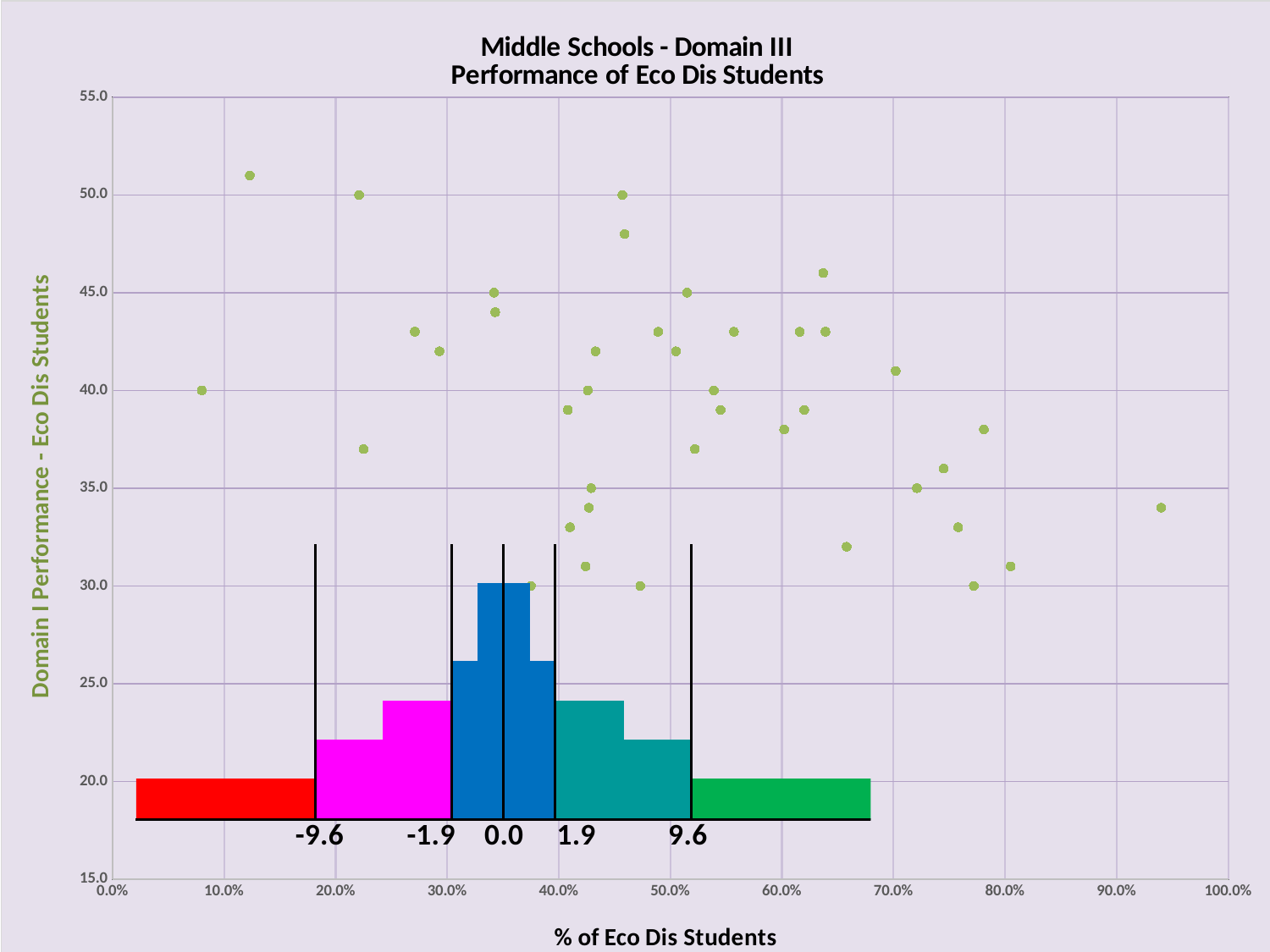
Is the value of the rightmost point (near 94% of Eco Dis Students) greater or less than 40.0? less Is the value of the highest point on the chart greater or less than 50.0? greater Is the value of the leftmost point (near 8% of Eco Dis Students) greater or less than 45.0? less What is the title of the x axis? % of Eco Dis Students What kind of chart is shown on the slide? scatter chart What is the title of the chart? Middle Schools - Domain III Performance of Eco Dis Students